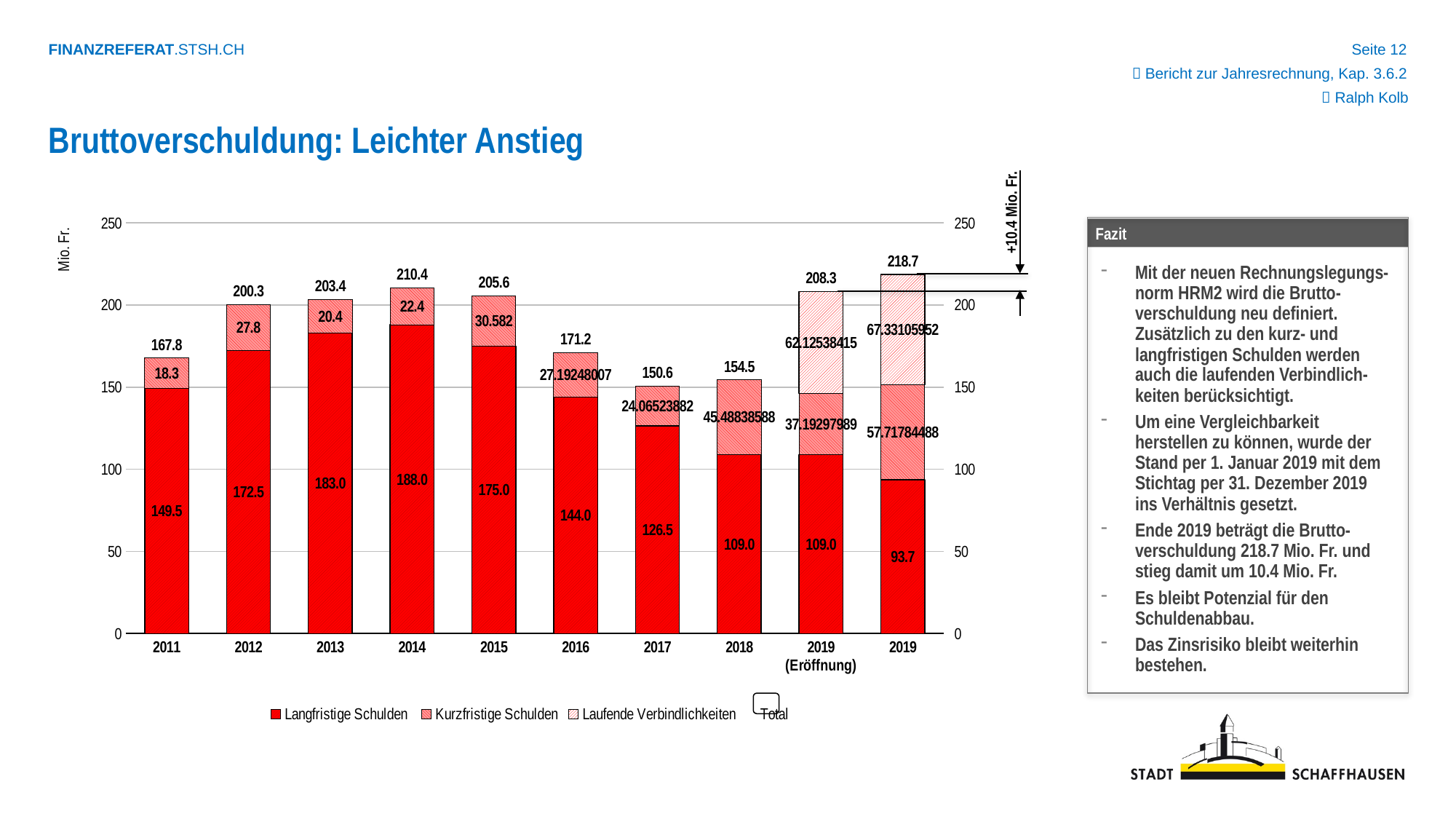
What is the difference between the total for 2019 and the total for 2019 (Eröffnung)? 10.4 Which is larger, Kurzfristige Schulden in 2012 or in 2013? 2012 In which year is Langfristige Schulden highest? 2014 What is the value of Laufende Verbindlichkeiten for 2019 (Eröffnung)? 62.12538415 How many bars are shown in the chart? 10 How many series does the legend list? 4 Does the total rise or fall from 2011 to 2014? Rise What is the total shown above the bar for 2019? 218.7 Which bar has the lowest total? 2017 What is the value of Langfristige Schulden for 2014? 188.0 What kind of chart is shown on the slide? Stacked bar chart What is the value of Kurzfristige Schulden for 2015? 30.582